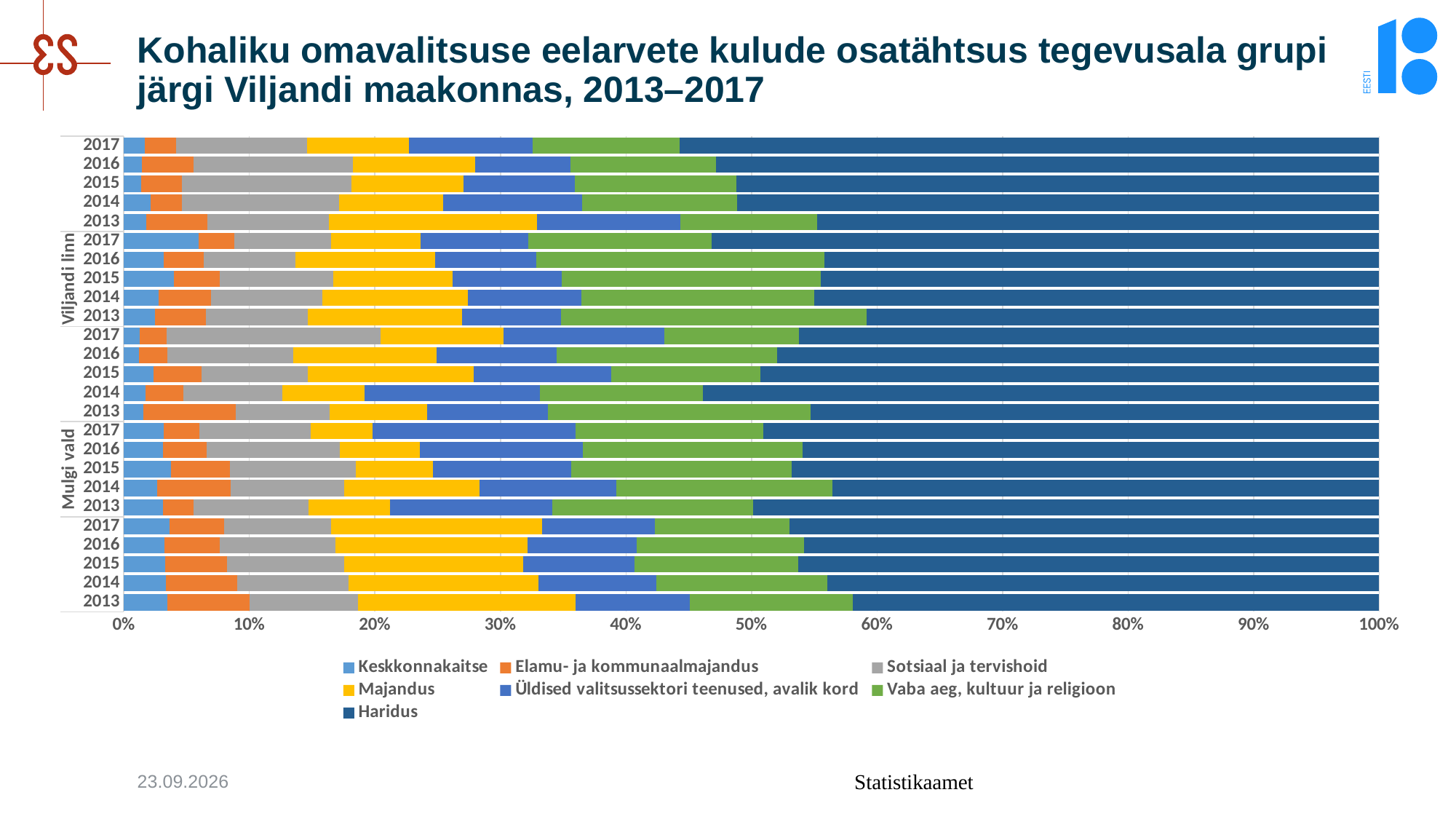
In Viljandi linn, is the Haridus share larger in 2017 or in 2013? 2017 Is the Haridus share for Viljandi linn in 2013 greater or less than 50%? less What is the total of each stacked bar in the chart? 100% Is the Haridus share for Viljandi linn in 2017 greater or less than 50%? greater What kind of chart is shown on the slide? Stacked bar chart Is the Haridus share for Mulgi vald in 2017 greater or less than 40%? greater How many bars (year rows) are plotted in the chart in total? 25 What is the highest value shown on the x axis? 100% What is the title of the chart on the slide? Kohaliku omavalitsuse eelarvete kulude osatähtsus tegevusala grupi järgi Viljandi maakonnas, 2013–2017 How many series does the legend list? 7 How many years are shown for the Viljandi linn group? 5 Which series is plotted as the rightmost segment of each bar? Haridus